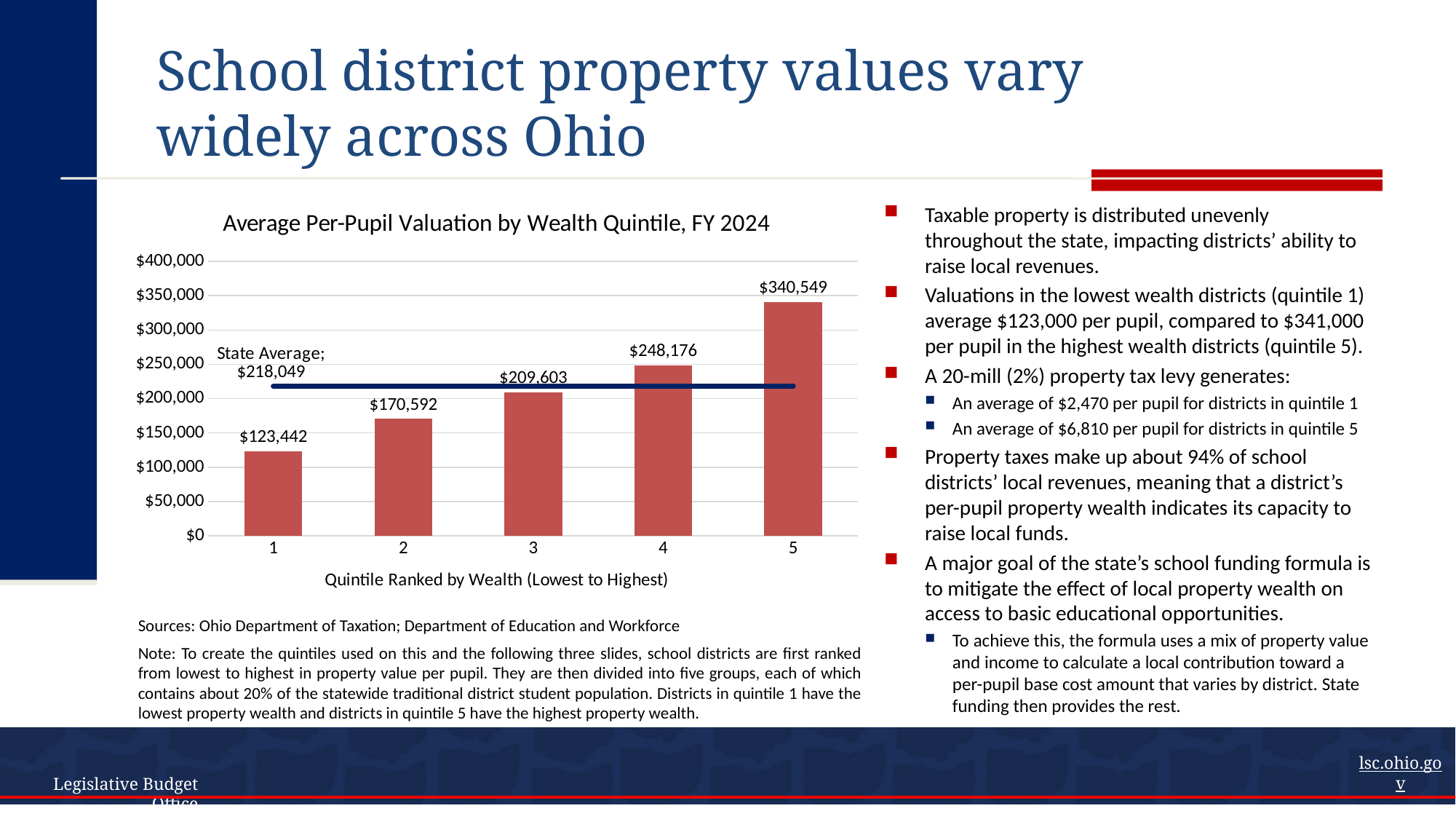
What is the state average per-pupil valuation shown by the horizontal line? $218,049 What is the difference between the average per-pupil valuation of quintile 4 and quintile 3? $38,573 Do the average per-pupil valuations rise or fall from quintile 1 to quintile 5? Rise Which quintile has the lowest average per-pupil valuation? 1 What is the average per-pupil valuation for quintile 1? $123,442 What type of chart is used to show average per-pupil valuation by wealth quintile? Bar chart Which is larger, the average per-pupil valuation of quintile 2 or quintile 4? Quintile 4 How many quintiles are plotted as bars in the chart? 5 What is the average per-pupil valuation for quintile 5? $340,549 What is the average per-pupil valuation for quintile 3? $209,603 Which quintile has the highest average per-pupil valuation? 5 What is the difference between the average per-pupil valuation of quintile 5 and quintile 1? $217,107